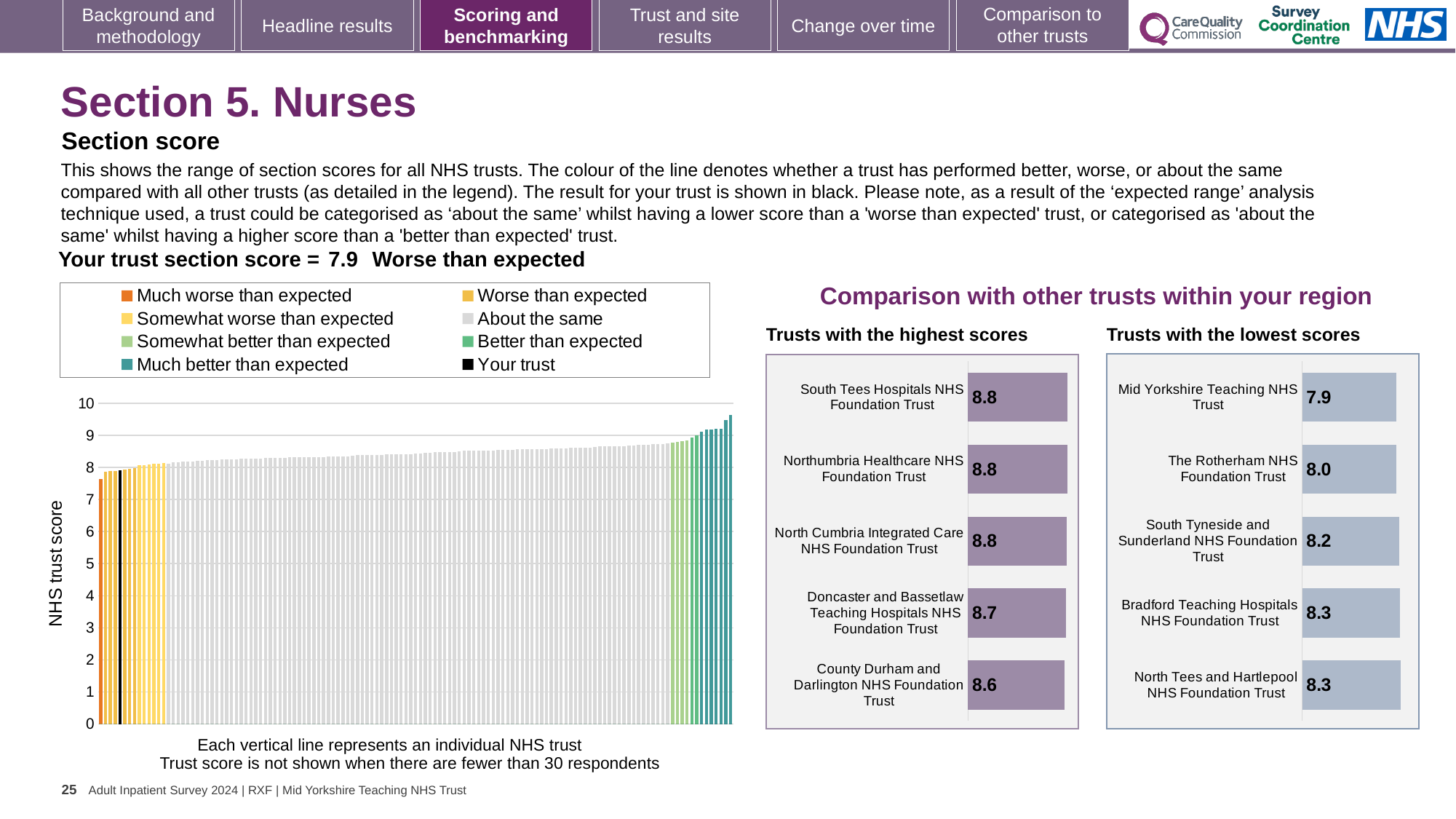
In the 'Trusts with the lowest scores' chart, what is the difference between the scores of Bradford Teaching Hospitals NHS Foundation Trust and Mid Yorkshire Teaching NHS Trust? 0.4 How many trusts are shown in the 'Trusts with the lowest scores' chart? 5 In the 'Trusts with the lowest scores' chart, what is the score for South Tyneside and Sunderland NHS Foundation Trust? 8.2 How many entries does the legend of the main NHS trust score chart list? 8 In the 'Trusts with the highest scores' chart, what is the score for South Tees Hospitals NHS Foundation Trust? 8.8 In the main NHS trust score chart, is the value of the tallest bar greater or less than 9? greater In the 'Trusts with the lowest scores' chart, which trust has the lowest score? Mid Yorkshire Teaching NHS Trust In the 'Trusts with the highest scores' chart, what is the difference between the scores of South Tees Hospitals NHS Foundation Trust and County Durham and Darlington NHS Foundation Trust? 0.2 In the 'Trusts with the highest scores' chart, which trust has the lowest score? County Durham and Darlington NHS Foundation Trust In the main NHS trust score chart, do the values rise or fall from left to right? Rise In the 'Trusts with the highest scores' chart, which has the higher score: Doncaster and Bassetlaw Teaching Hospitals NHS Foundation Trust or County Durham and Darlington NHS Foundation Trust? Doncaster and Bassetlaw Teaching Hospitals NHS Foundation Trust What kind of chart is the main NHS trust score chart on the left? Bar chart